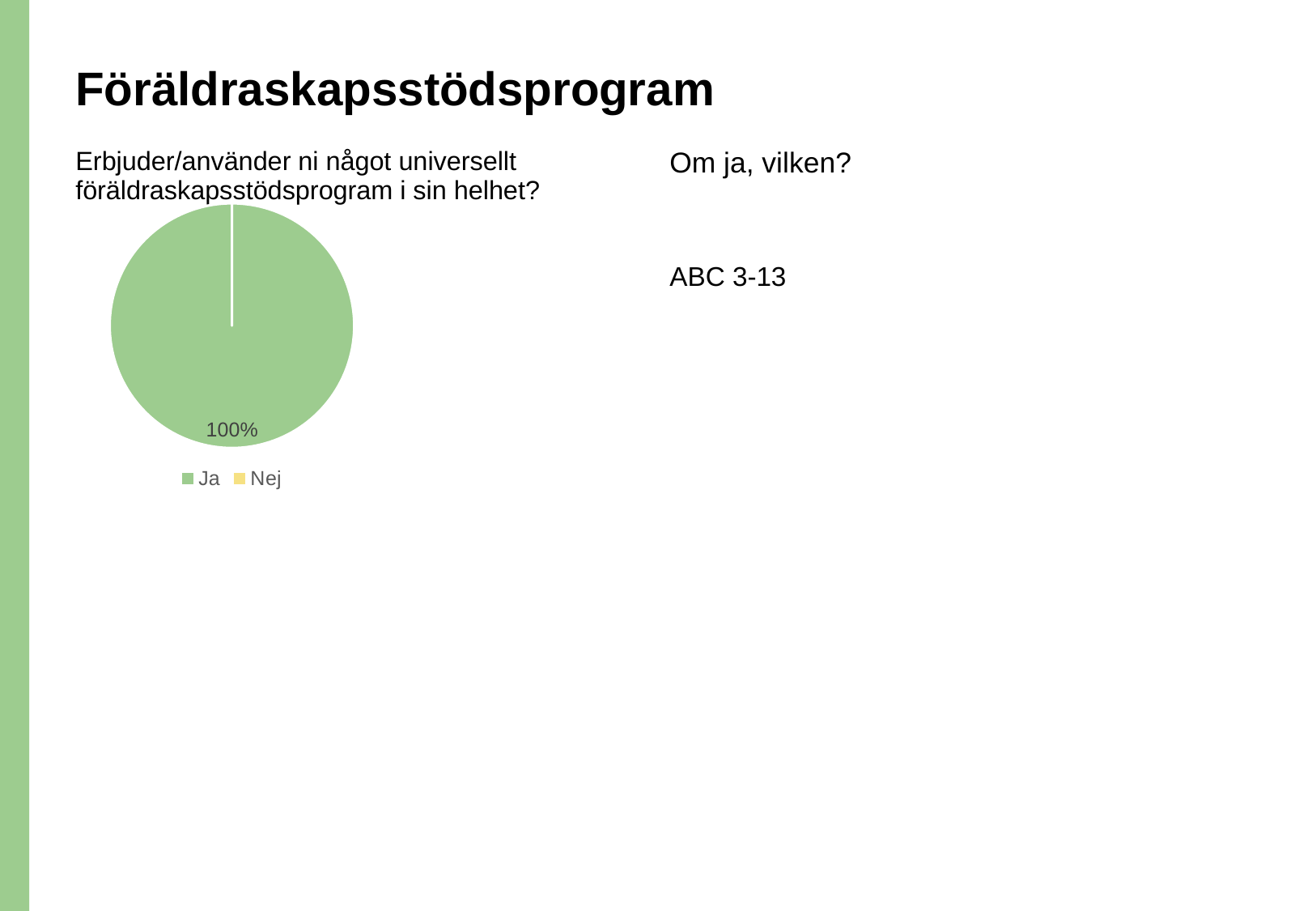
What share of the pie does "Ja" represent? 100% What kind of chart is shown on the slide? pie chart What question does the pie chart answer, according to its title? Erbjuder/använder ni något universellt föräldraskapsstödsprogram i sin helhet? Which category has the largest share of the pie? Ja How many entries does the legend list? 2 What is the value shown for "Ja" in the pie chart? 100% What colour is used for "Ja" in the pie chart? green Which is larger, the share for "Ja" or the share for "Nej"? Ja